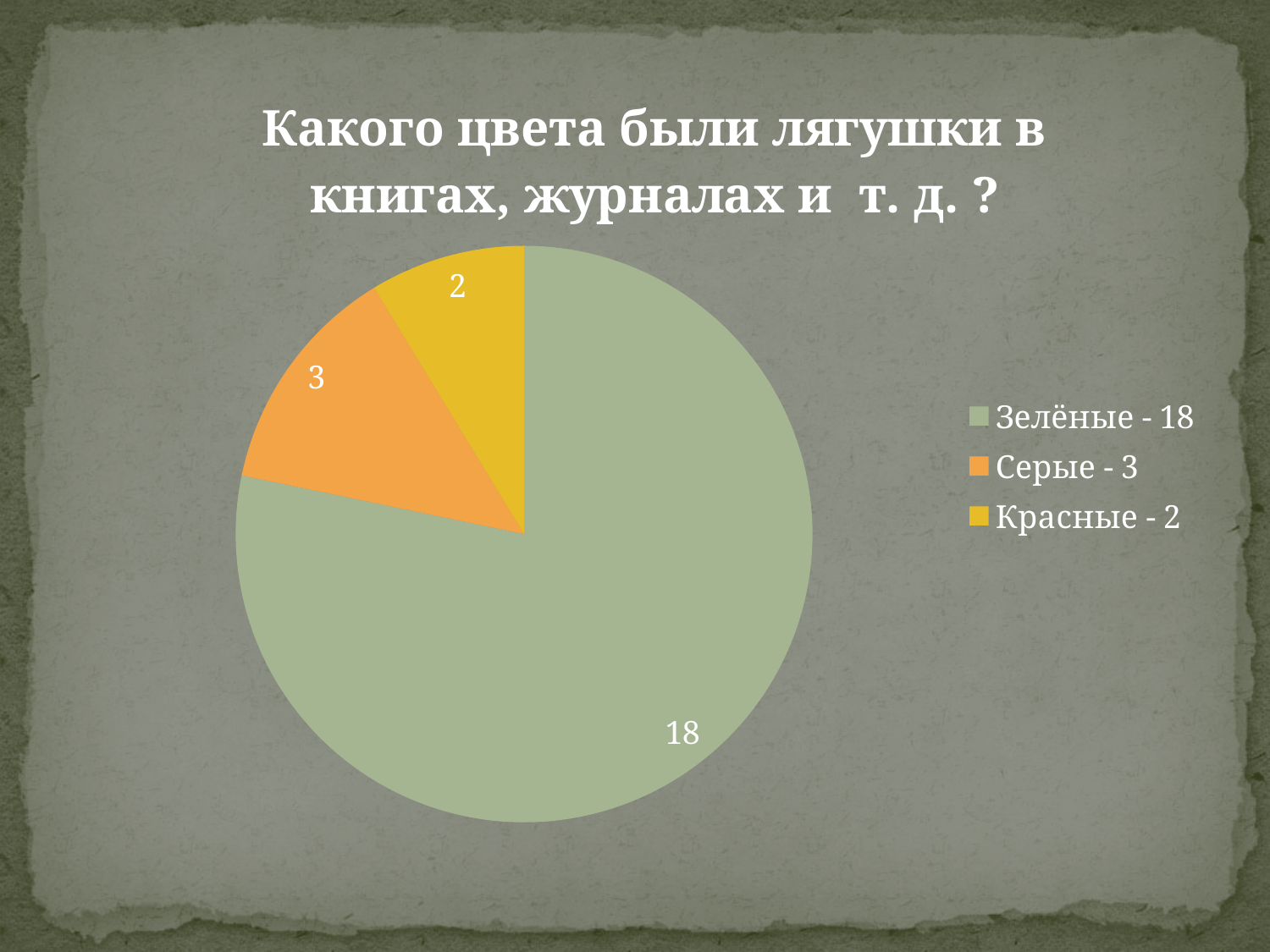
Which category has the largest slice of the pie? Зелёные What value is shown for the Зелёные slice? 18 How many slices does the pie chart have? 3 What is the difference between the values for Зелёные and Серые? 15 What colour is the Красные slice in the pie chart? Yellow Which is larger, the value for Серые or the value for Красные? Серые What value is shown for the Красные slice? 2 What is the total of all the slice values in the pie chart? 23 How many entries does the legend list? 3 Which category has the smallest slice of the pie? Красные What value is shown for the Серые slice? 3 What kind of chart is shown on the slide? Pie chart